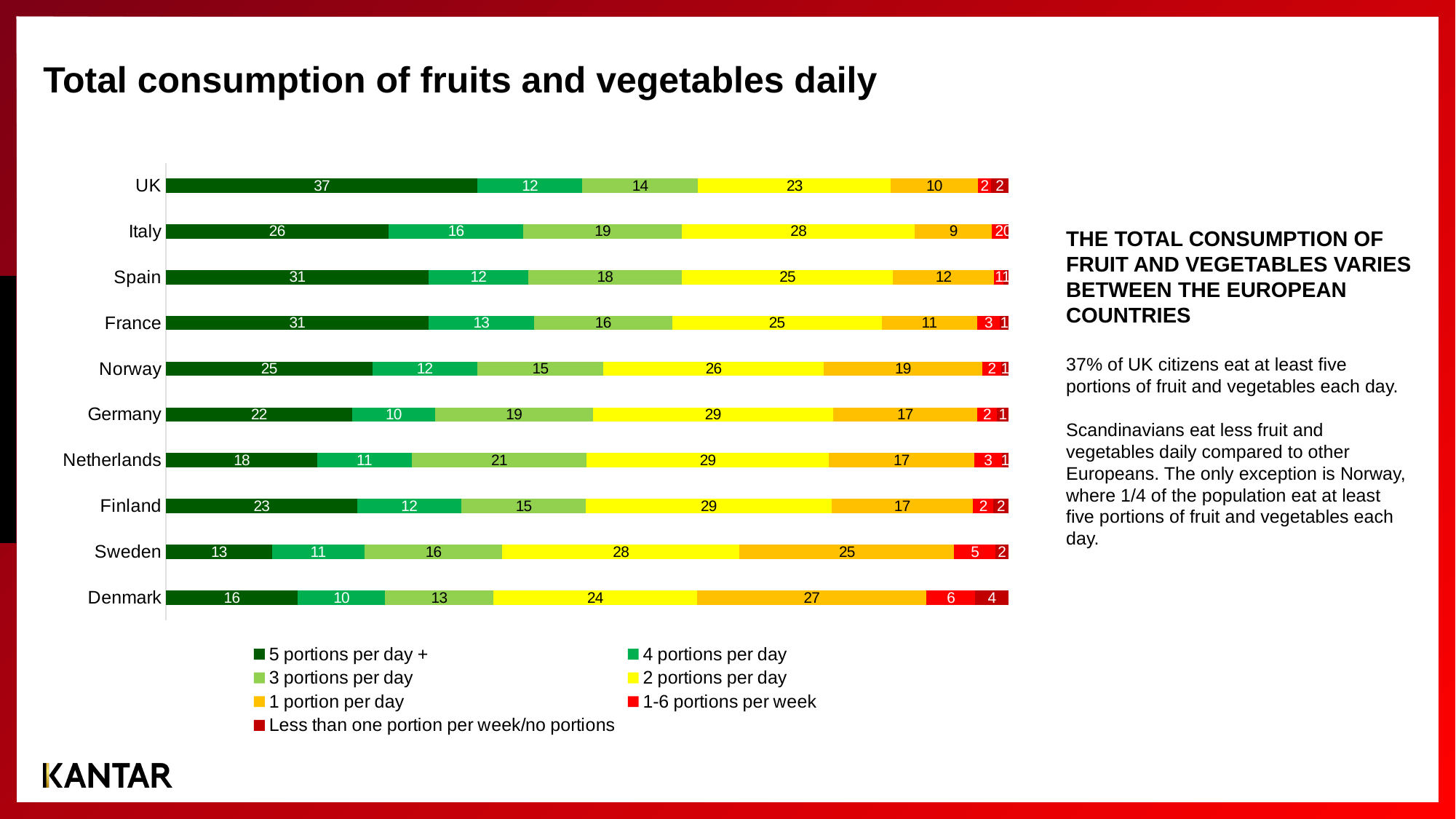
What is the value for Denmark in the '1 portion per day' series? 27 Which country has the highest value for '5 portions per day +'? UK How many countries are shown in the chart? 10 Which country has the highest value for '1 portion per day'? Denmark What is the value for the Netherlands in the '3 portions per day' series? 21 What kind of chart is shown on the slide? Stacked bar chart What is the value for the UK in the '5 portions per day +' series? 37 What is the difference between the UK and Sweden in the '5 portions per day +' series? 24 Which country has the lowest value for '5 portions per day +'? Sweden What is the total of the stacked bar for Denmark? 100 How many series does the legend list? 7 Which has the larger value for '5 portions per day +', Norway or Germany? Norway